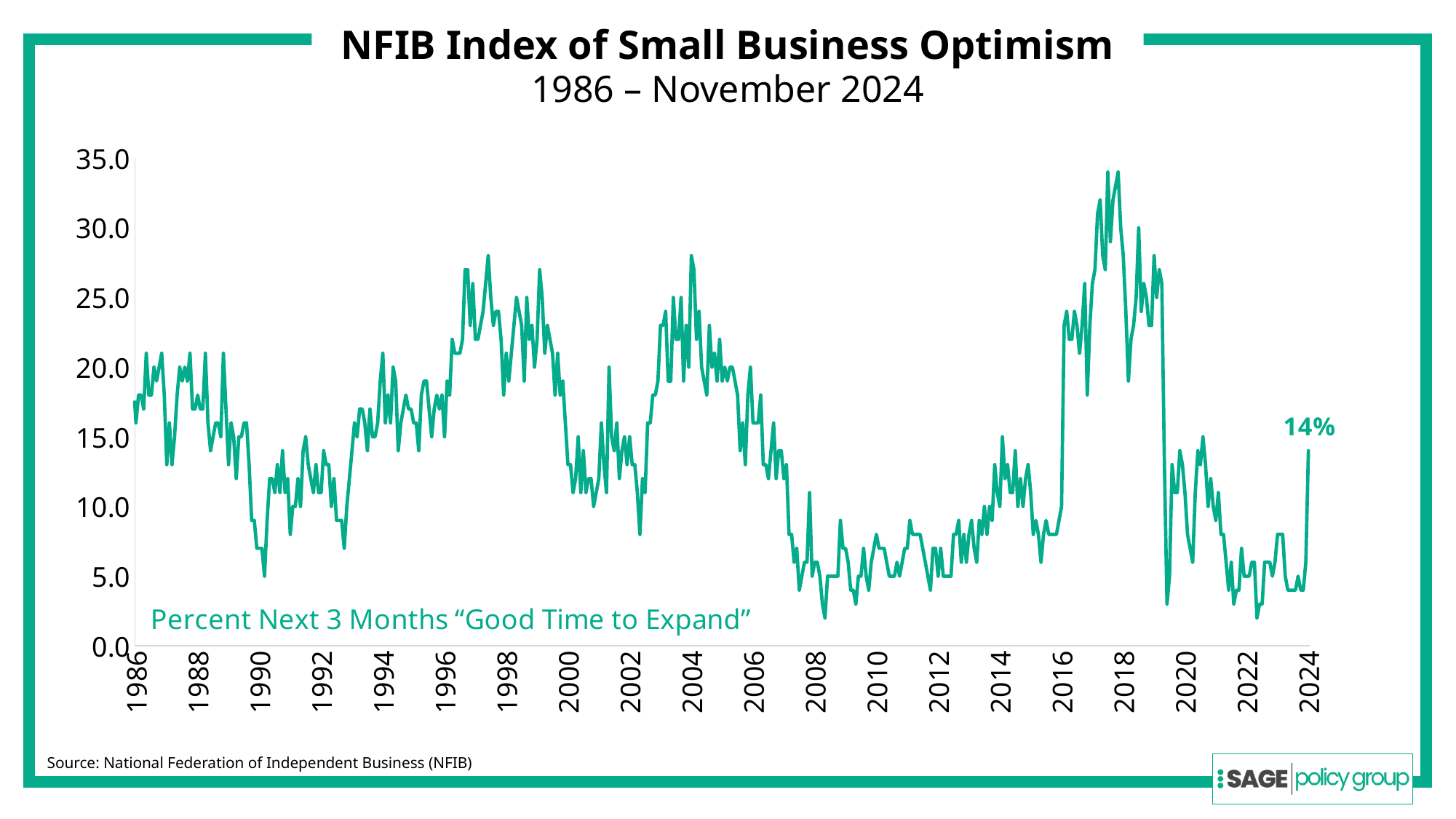
Is the highest point of the line, reached around 2018, greater or less than 30? greater What is the value labelled at the end of the line in 2024? 14% Is the value of the line in 2012 greater or less than 10? less What kind of chart is shown on the slide? line chart What series label is printed inside the plot area? Percent Next 3 Months "Good Time to Expand" How many year labels are shown on the x axis? 20 Is the peak of the line around 2004 greater or less than 25? greater Does the line rise or fall between 2016 and 2018? rise What is the highest value shown on the y axis? 35.0 What is the title of the chart? NFIB Index of Small Business Optimism Does the line rise or fall between 2019 and 2020? fall